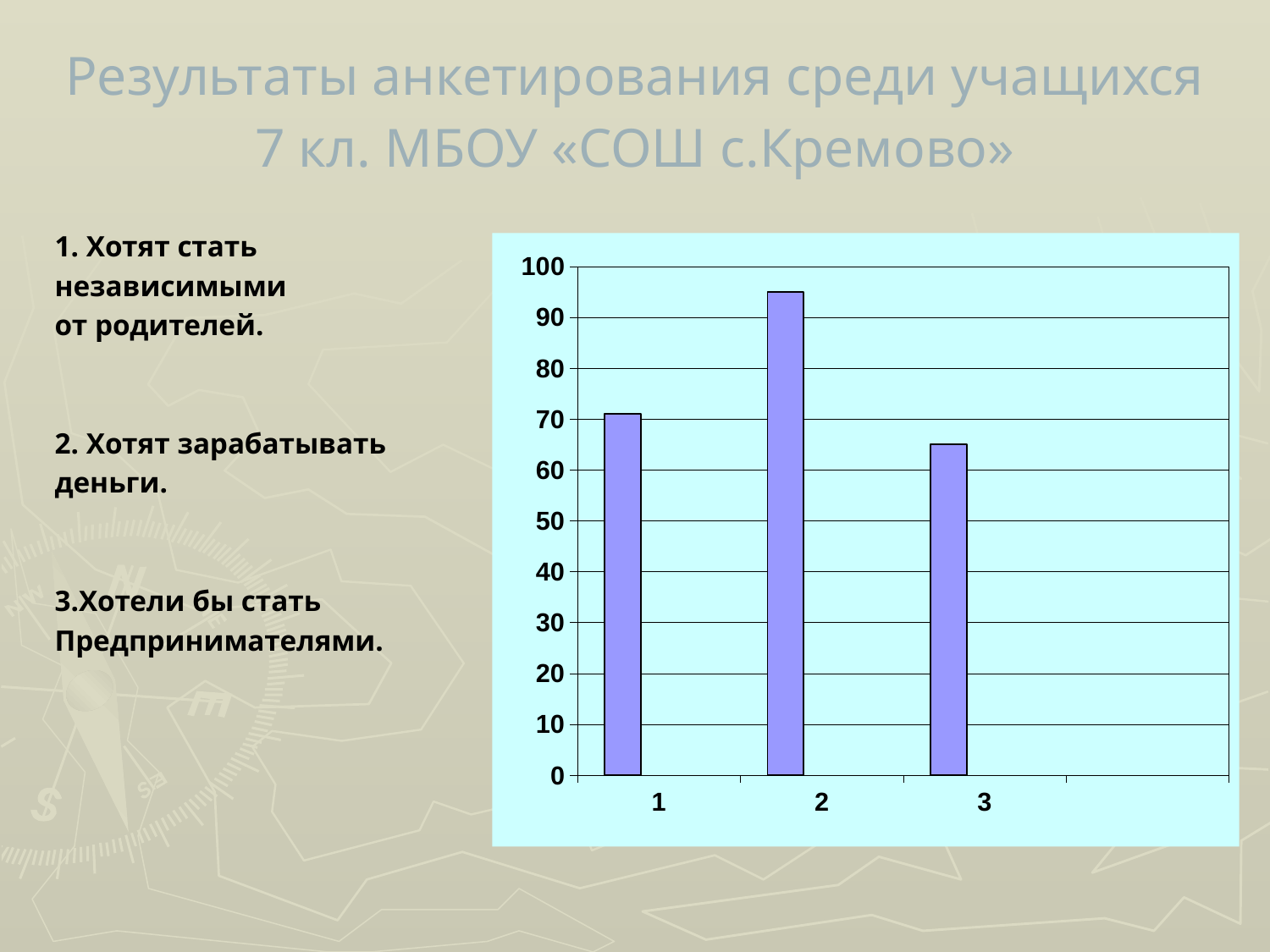
Which category has the lowest bar? 3 Is the value for category 3 greater or less than 70? less Which category has the highest bar? 2 Does the value rise or fall from category 2 to category 3? fall What kind of chart is shown on the slide? bar chart Is the value for category 1 greater or less than 80? less What is the highest value shown on the vertical axis of the chart? 100 How many bars (categories) does the chart show? 3 Which is larger, the value for category 1 or the value for category 3? category 1 Is the value for category 2 greater or less than 90? greater Which is larger, the value for category 2 or the value for category 1? category 2